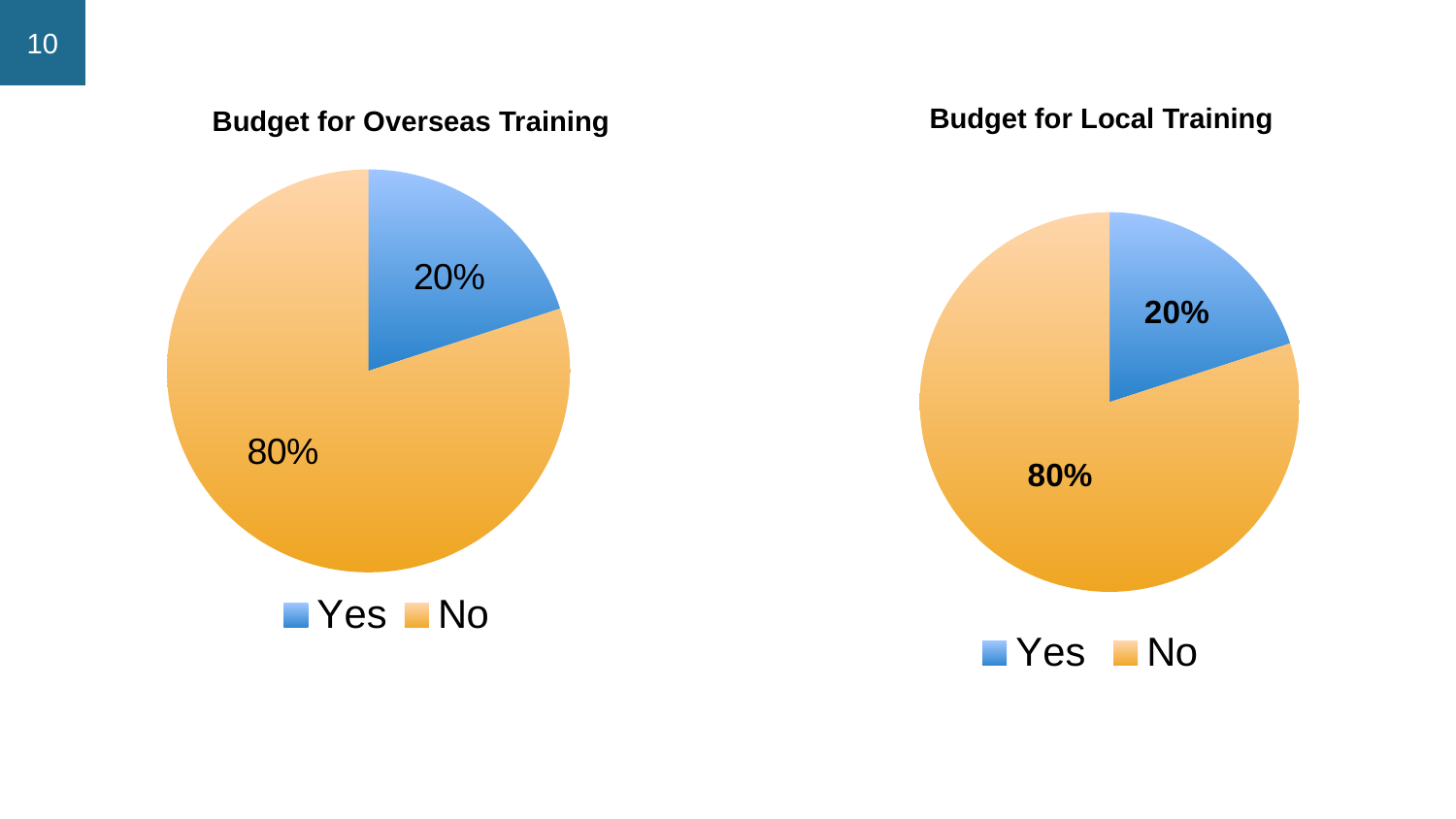
In the 'Budget for Overseas Training' chart, what share of the pie is 'No'? 80% In the 'Budget for Overseas Training' chart, which category has the largest slice? No In the 'Budget for Local Training' chart, which category has the smallest slice? Yes What is the title of the chart on the right side of the slide? Budget for Local Training In the 'Budget for Overseas Training' chart, what is the difference between the 'No' and 'Yes' shares? 60% In the 'Budget for Overseas Training' chart, what colour is the 'Yes' slice? Blue What kind of chart is the 'Budget for Local Training' chart? Pie chart In the 'Budget for Local Training' chart, which is larger, 'Yes' or 'No'? No In the 'Budget for Local Training' chart, what share of the pie is 'Yes'? 20% In the 'Budget for Overseas Training' chart, what share of the pie is 'Yes'? 20% How many categories does the 'Budget for Overseas Training' chart show? 2